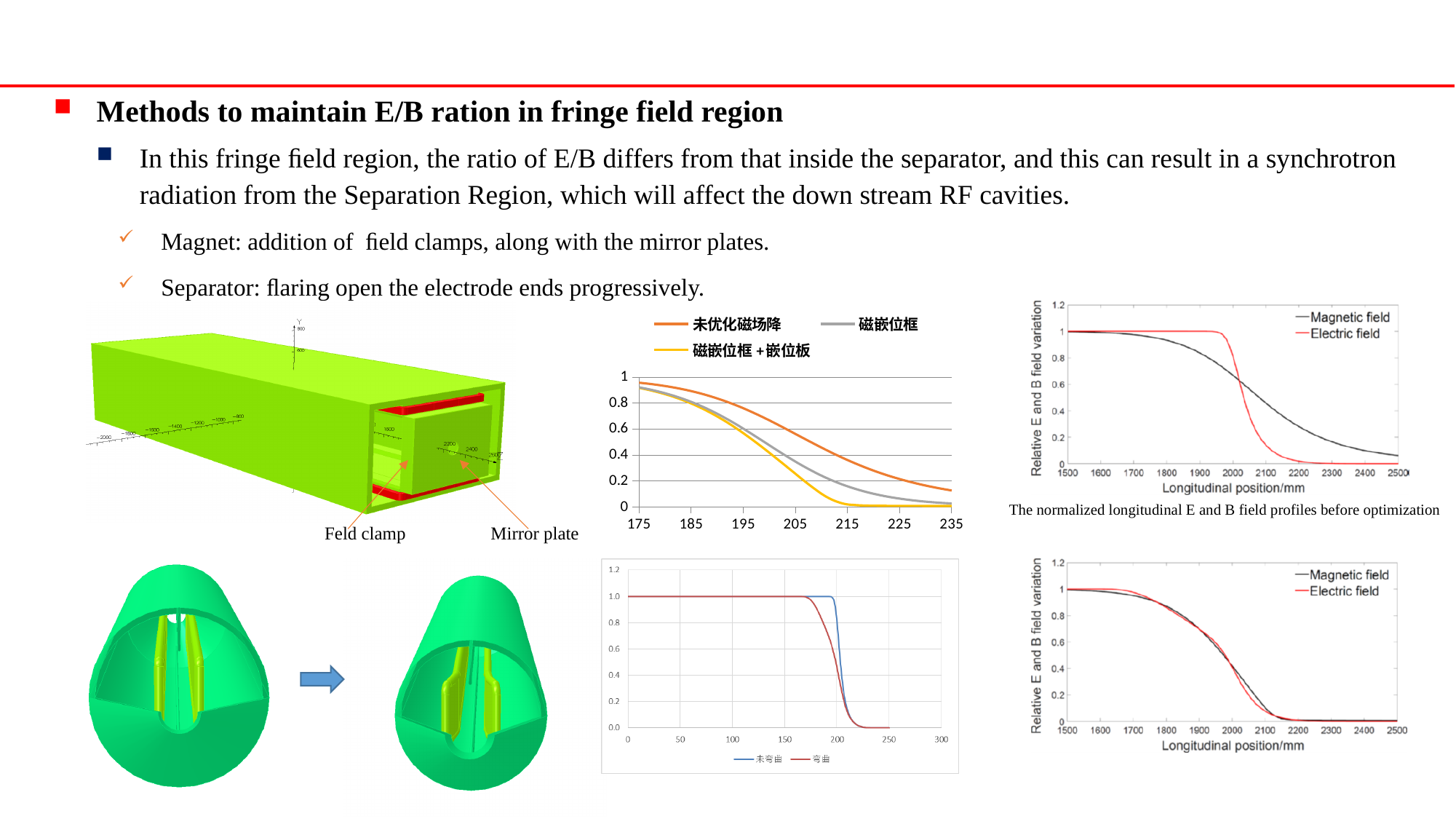
In the top middle line chart (x axis 175 to 235), which series has the highest value at x = 215? 未优化磁场降 In the top middle line chart (x axis 175 to 235), at x = 205, which series is larger: 未优化磁场降 or 磁嵌位框 +嵌位板? 未优化磁场降 In the top middle line chart (x axis 175 to 235), do the values rise or fall as x increases? fall In the top middle line chart (x axis 175 to 235), how many series does the legend list? 3 In the bottom middle line chart (x axis 0 to 300), what is the value of the 未弯曲 series at x = 100? 1.0 In the top right chart titled 'The normalized longitudinal E and B field profiles before optimization', is the Magnetic field value at 2300 mm greater or less than 0.2? less In the top middle line chart (x axis 175 to 235), is the value of the 磁嵌位框 +嵌位板 series at x = 215 greater or less than 0.2? less What kind of chart is the top middle chart with the x axis from 175 to 235? line chart What is the x axis label of the bottom right chart showing Magnetic field and Electric field? Longitudinal position/mm In the top right chart titled 'The normalized longitudinal E and B field profiles before optimization', at a longitudinal position of 2000 mm, which is larger: the Magnetic field or the Electric field? Electric field In the top middle line chart (x axis 175 to 235), is the value of the 未优化磁场降 series at x = 205 greater or less than 0.4? greater In the bottom middle line chart (x axis 0 to 300), how many series does the legend list? 2